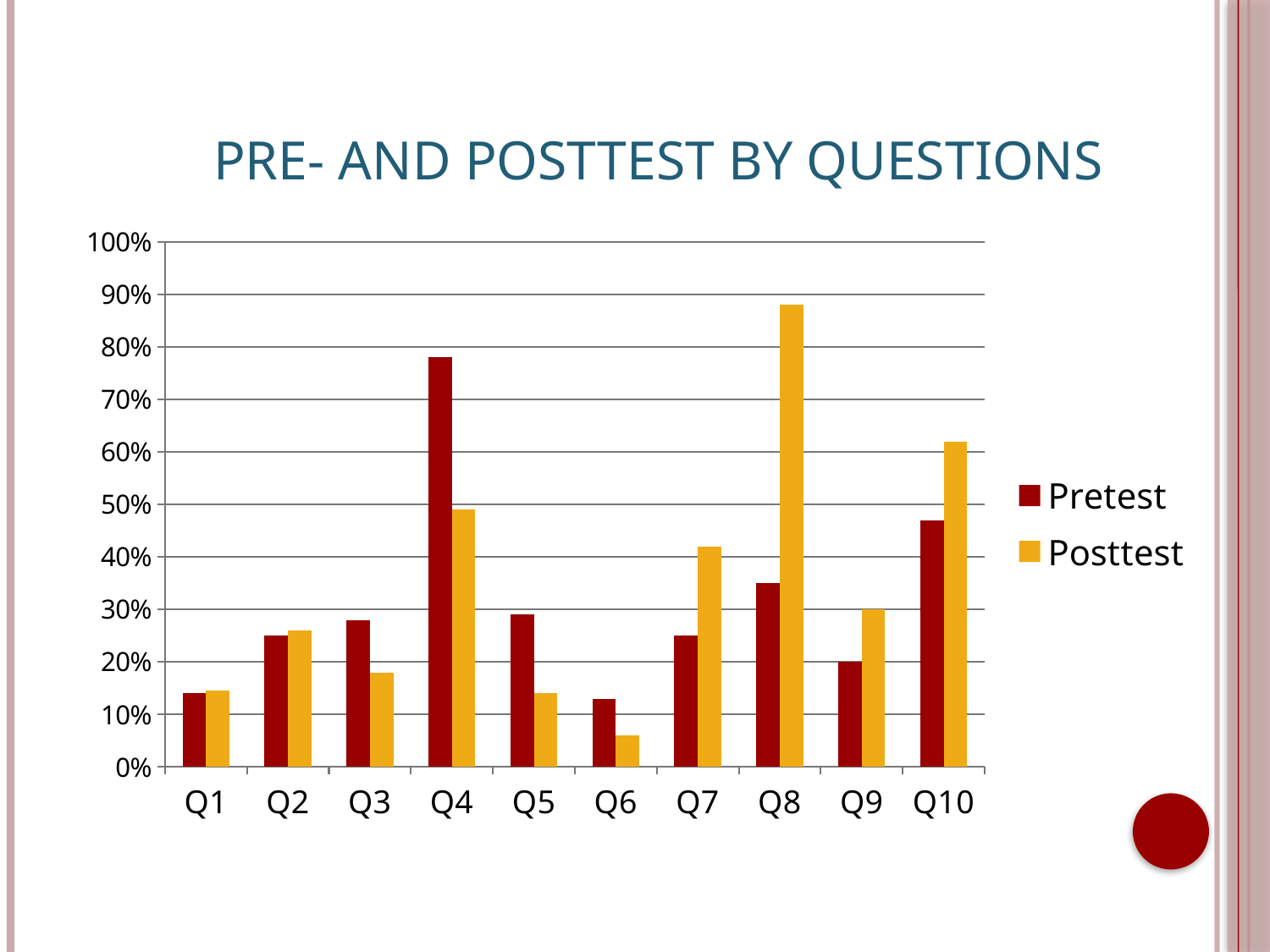
Is the Posttest value for Q8 greater or less than 80%? greater Which question has the highest Pretest value? Q4 How many questions (categories) are shown on the x axis? 10 Is the Pretest value for Q4 greater or less than 70%? greater Is the Posttest value for Q6 greater or less than 10%? less For Q4, which is larger, the Pretest or the Posttest value? Pretest How many series does the legend list? 2 What kind of chart is shown on the slide? bar chart What is the title of the chart? PRE- AND POSTTEST BY QUESTIONS Which question has the highest Posttest value? Q8 For Q7, which is larger, the Pretest or the Posttest value? Posttest Which question has the lowest Posttest value? Q6